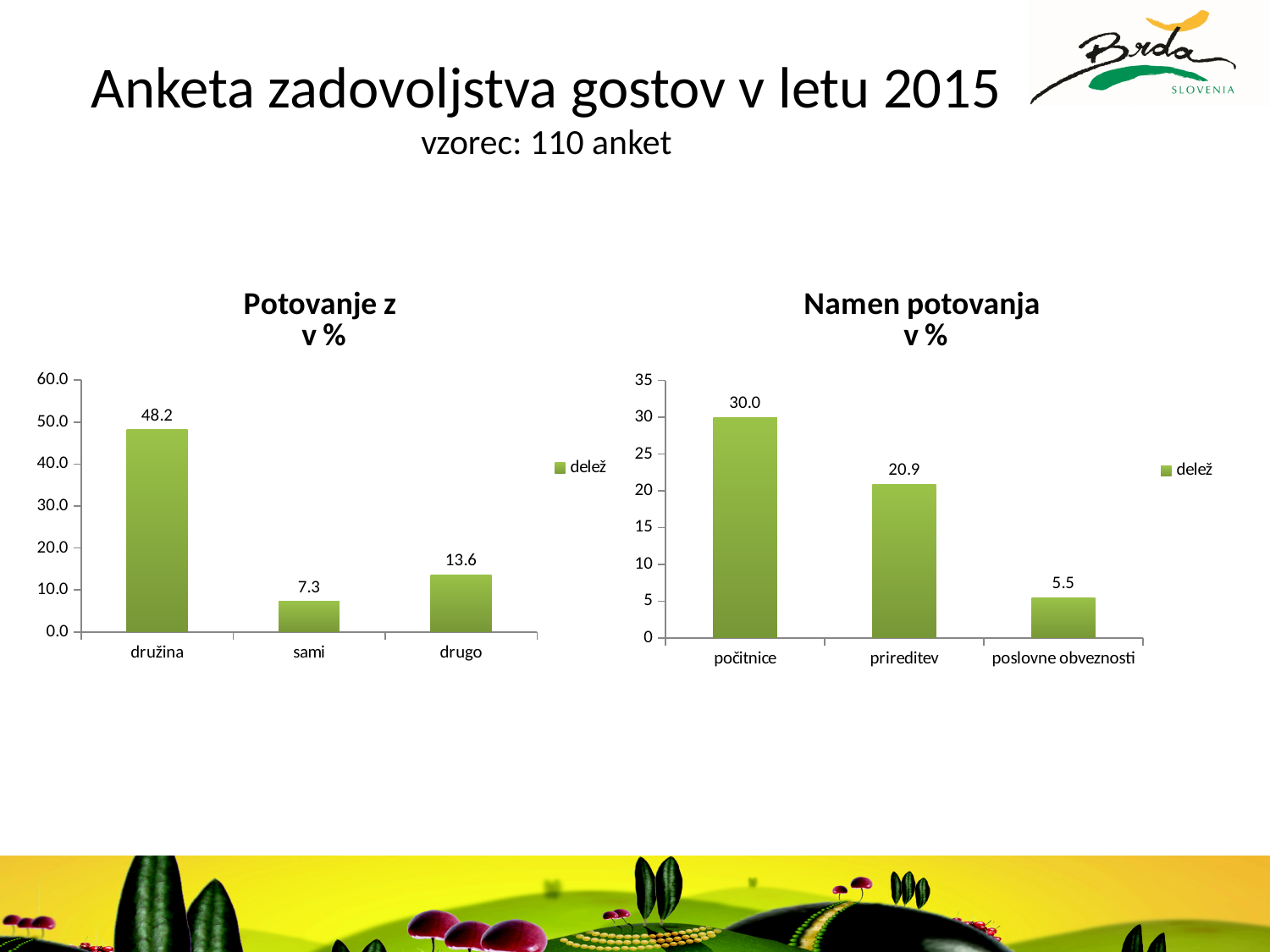
In the 'Namen potovanja v %' chart, what is the difference between počitnice and prireditev? 9.1 In the 'Potovanje z v %' chart, which category has the lowest value? sami How many series does the legend of the 'Potovanje z v %' chart list? 1 In the 'Potovanje z v %' chart, what is the difference between družina and drugo? 34.6 In the 'Potovanje z v %' chart, how many categories are shown? 3 In the 'Potovanje z v %' chart, what is the value for družina? 48.2 In the 'Namen potovanja v %' chart, which is larger, prireditev or poslovne obveznosti? prireditev In the 'Potovanje z v %' chart, what is the value for sami? 7.3 In the 'Namen potovanja v %' chart, what is the value for prireditev? 20.9 What kind of chart is the 'Namen potovanja v %' chart? bar chart In the 'Namen potovanja v %' chart, what is the value for poslovne obveznosti? 5.5 In the 'Namen potovanja v %' chart, which category has the highest value? počitnice